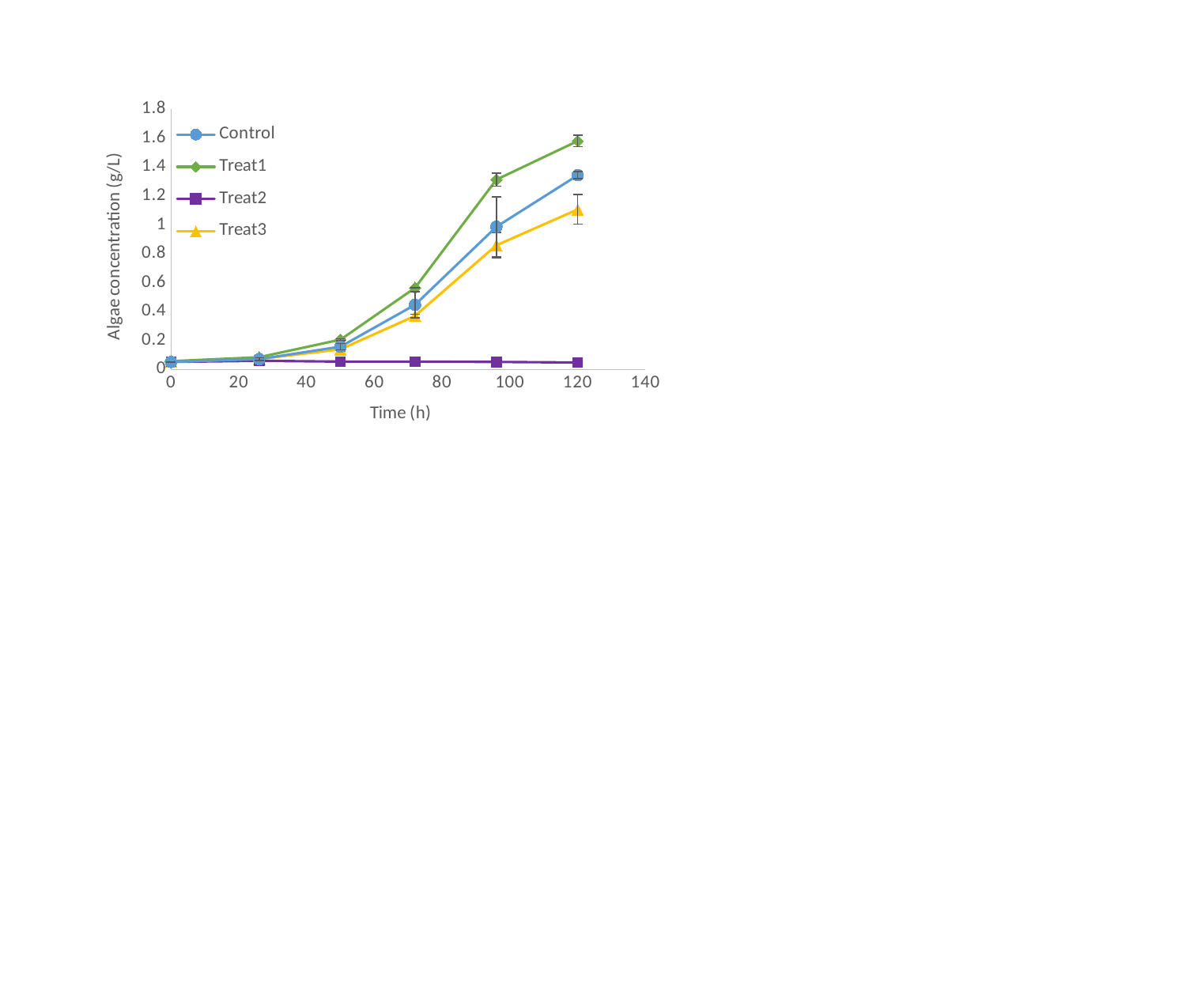
What is the label of the y axis? Algae concentration (g/L) Which series has the lowest algae concentration at 120 h? Treat2 Is the Treat2 value at 120 h greater or less than 0.2? less Is the Treat1 value at 120 h greater or less than 1.4? greater Is the Control value at 120 h greater or less than 1.2? greater How many series does the legend list? 4 What kind of chart is shown on the slide? line chart Which series has the highest algae concentration at 120 h? Treat1 At 96 h, which is larger: the Control value or the Treat3 value? Control Does the Treat1 series rise or fall as time increases from 0 to 120 h? rise At 120 h, which is larger: the Treat1 value or the Control value? Treat1